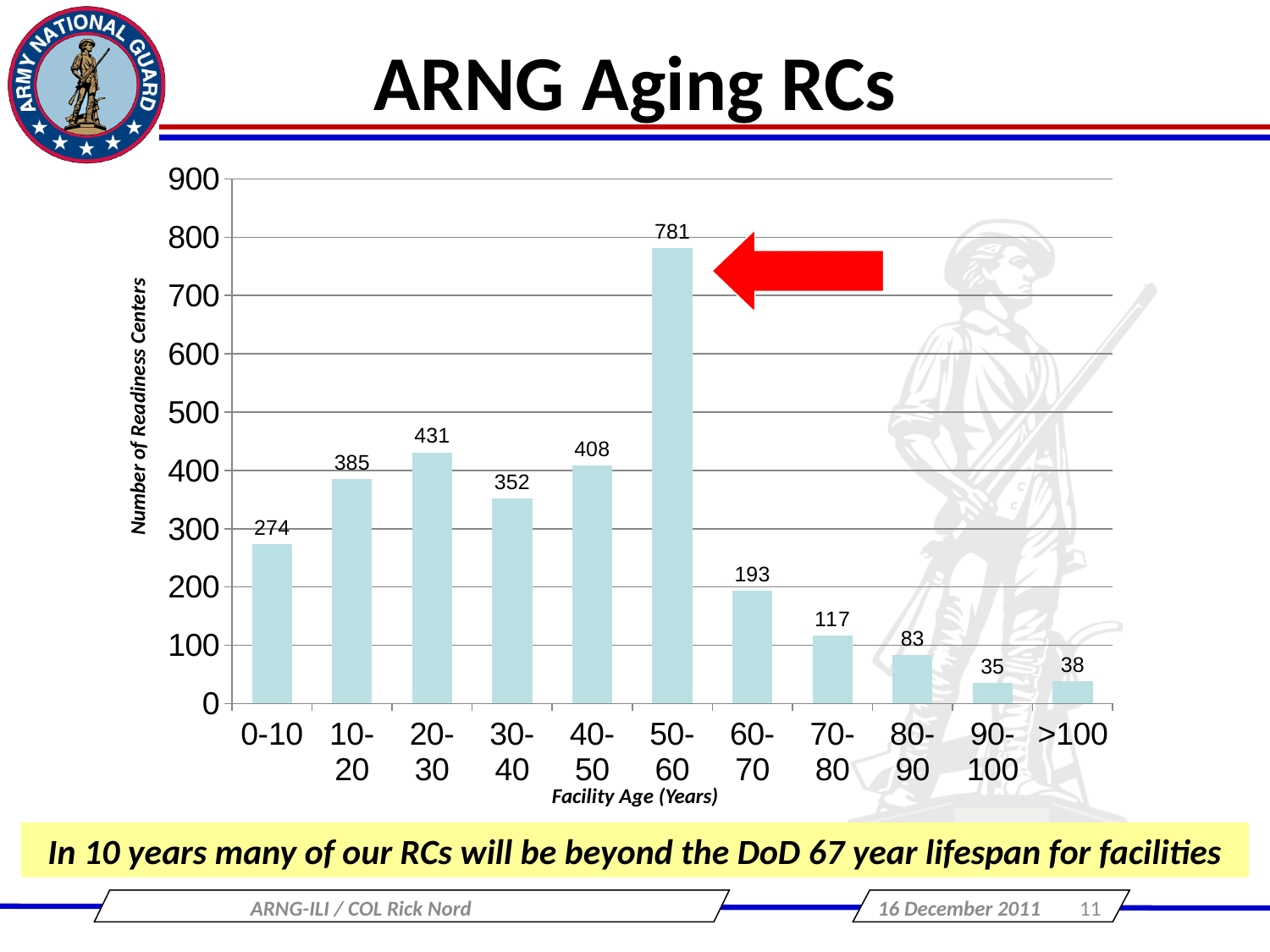
Which facility age group has the lowest number of Readiness Centers? 90-100 How many Readiness Centers are in the 50-60 year facility age group? 781 Do the values rise or fall from the 60-70 age group to the 90-100 age group? fall Which has more Readiness Centers, the 20-30 age group or the 40-50 age group? 20-30 What kind of chart is shown on the slide? bar chart Is the value for the 30-40 age group greater or less than 400? less What is the difference between the number of Readiness Centers in the 50-60 group and the 60-70 group? 588 How many Readiness Centers are shown for the >100 year age group? 38 What is the number of Readiness Centers for the 0-10 year age group? 274 Which facility age group has the highest number of Readiness Centers? 50-60 How many facility age groups are shown on the x axis? 11 What is the label of the y axis? Number of Readiness Centers